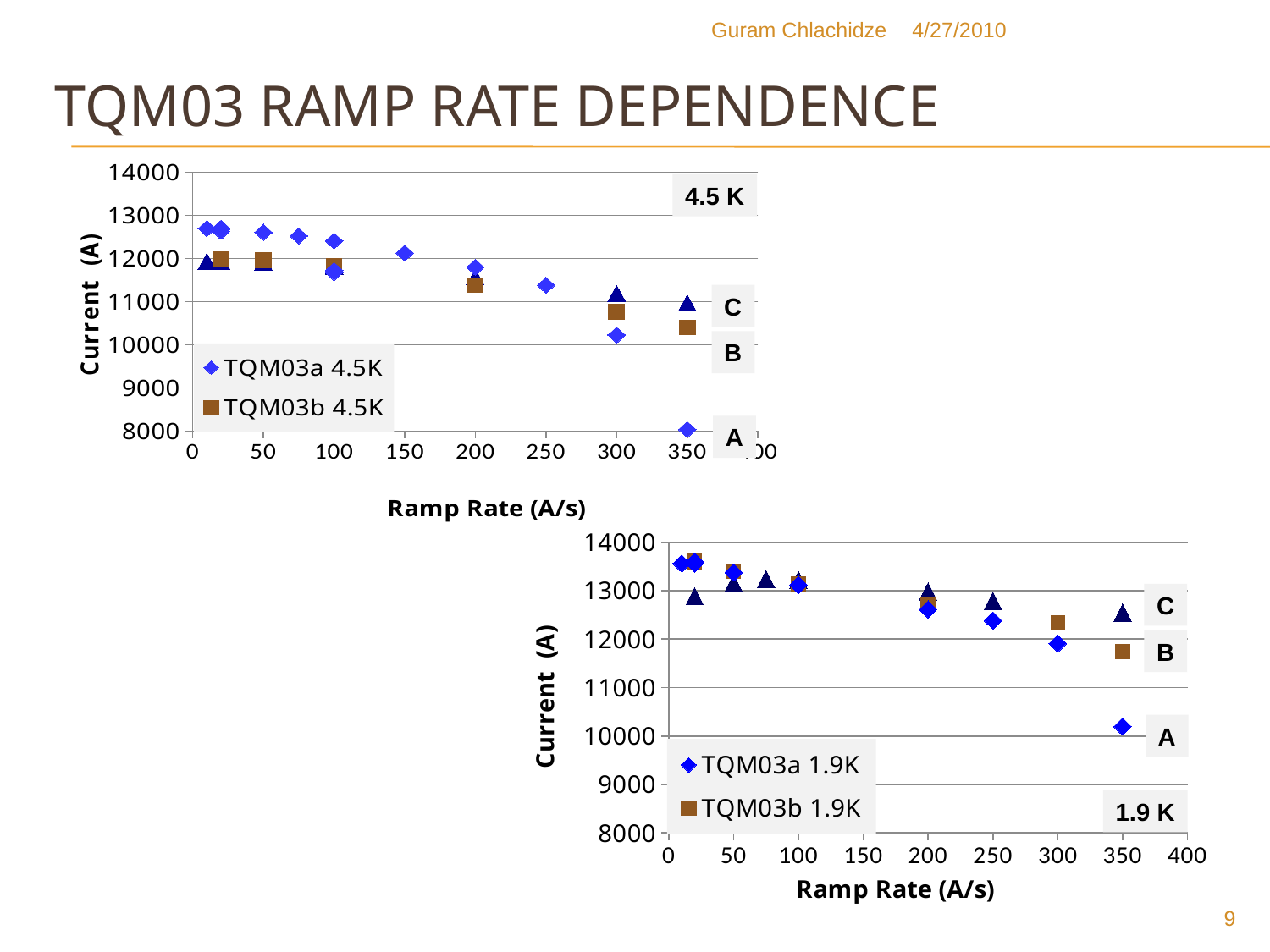
In the 4.5 K chart, does the current for TQM03a 4.5K rise or fall as the ramp rate increases? fall In the 4.5 K chart, at a ramp rate of 350 A/s, which series has the higher current, TQM03a 4.5K or TQM03b 4.5K? TQM03b 4.5K What kind of chart is the 4.5 K chart? scatter chart In the 4.5 K chart, is the value for TQM03b 4.5K at a ramp rate of 350 A/s greater or less than 10000? greater In the 4.5 K chart, is the value for TQM03a 4.5K at a ramp rate of 350 A/s greater or less than 9000? less What is the x-axis label of the 1.9 K chart? Ramp Rate (A/s) In the 1.9 K chart, is the value for TQM03b 1.9K at a ramp rate of 350 A/s greater or less than 12000? less How many series does the legend of the 1.9 K chart list? 2 In the 1.9 K chart, at a ramp rate of 350 A/s, which series has the higher current, TQM03a 1.9K or TQM03b 1.9K? TQM03b 1.9K In the 1.9 K chart, does the current for TQM03b 1.9K rise or fall as the ramp rate increases? fall What are the legend entries of the 4.5 K chart? TQM03a 4.5K, TQM03b 4.5K